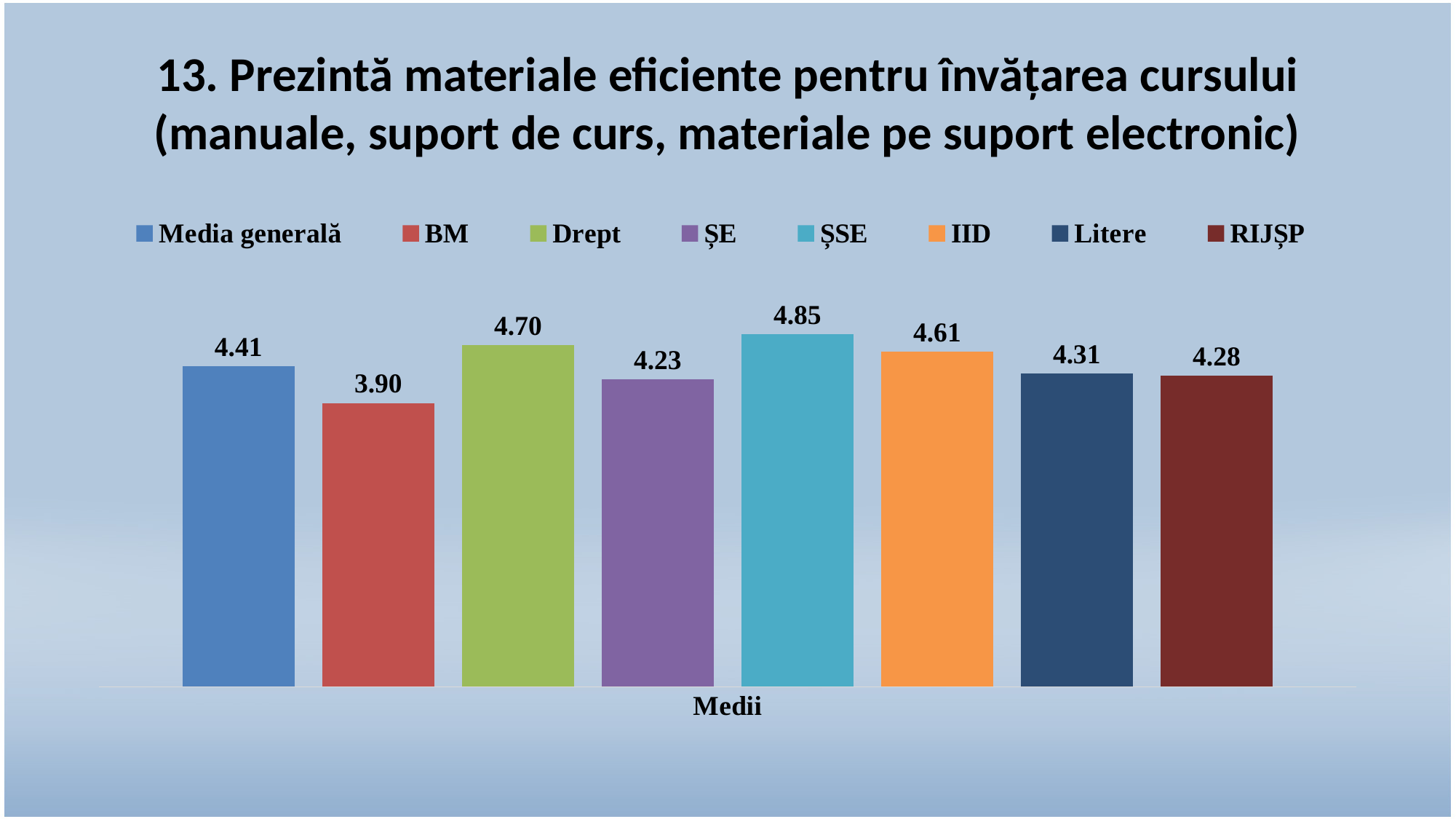
What is the value for Drept? 4.70 Which is larger, the value for Drept or the value for IID? Drept What is the difference between the values for ȘSE and BM? 0.95 Which series has the highest value? ȘSE How many series does the legend list? 8 Which series has the lowest value? BM What is the difference between the values for IID and ȘE? 0.38 What is the value for Litere? 4.31 What is the value for BM? 3.90 What is the label shown on the x axis of the chart? Medii What is the value for Media generală? 4.41 What kind of chart is shown on the slide? Bar chart